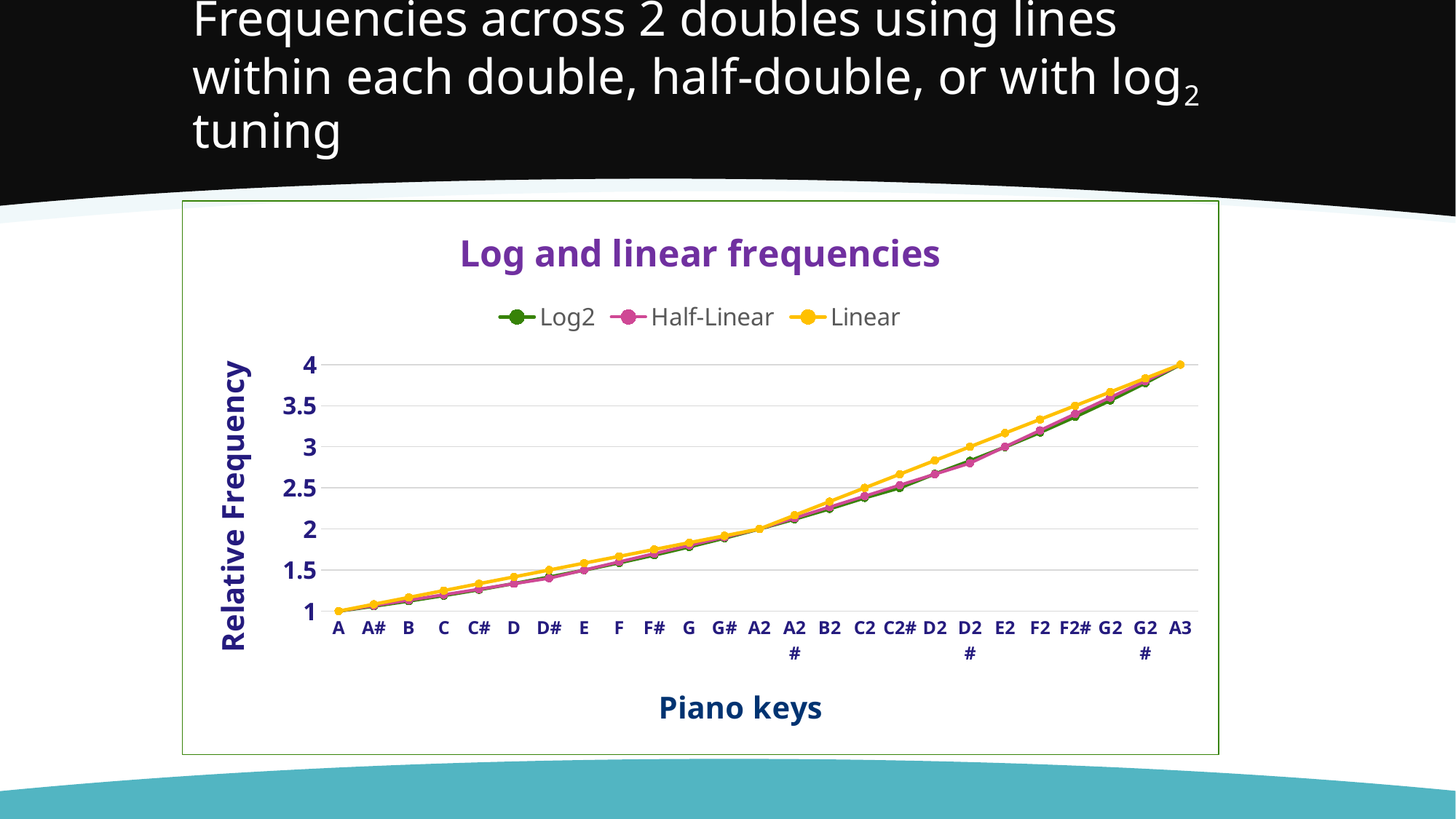
What is the title of the chart? Log and linear frequencies What kind of chart is shown on the slide? line chart What is the label of the y axis? Relative Frequency Which piano key has the lowest relative frequency for the Log2 series? A Is the Log2 value at key D2 greater or less than 3? less What is the relative frequency of the Linear series at key D2#? 3 What is the relative frequency of the Log2 series at key A2? 2 Do the relative frequency values rise or fall from key A to key A3? rise How many series does the legend list? 3 Which piano key has the highest relative frequency for the Linear series? A3 How many piano keys are shown along the x axis? 25 What is the relative frequency of the Linear series at key A3? 4